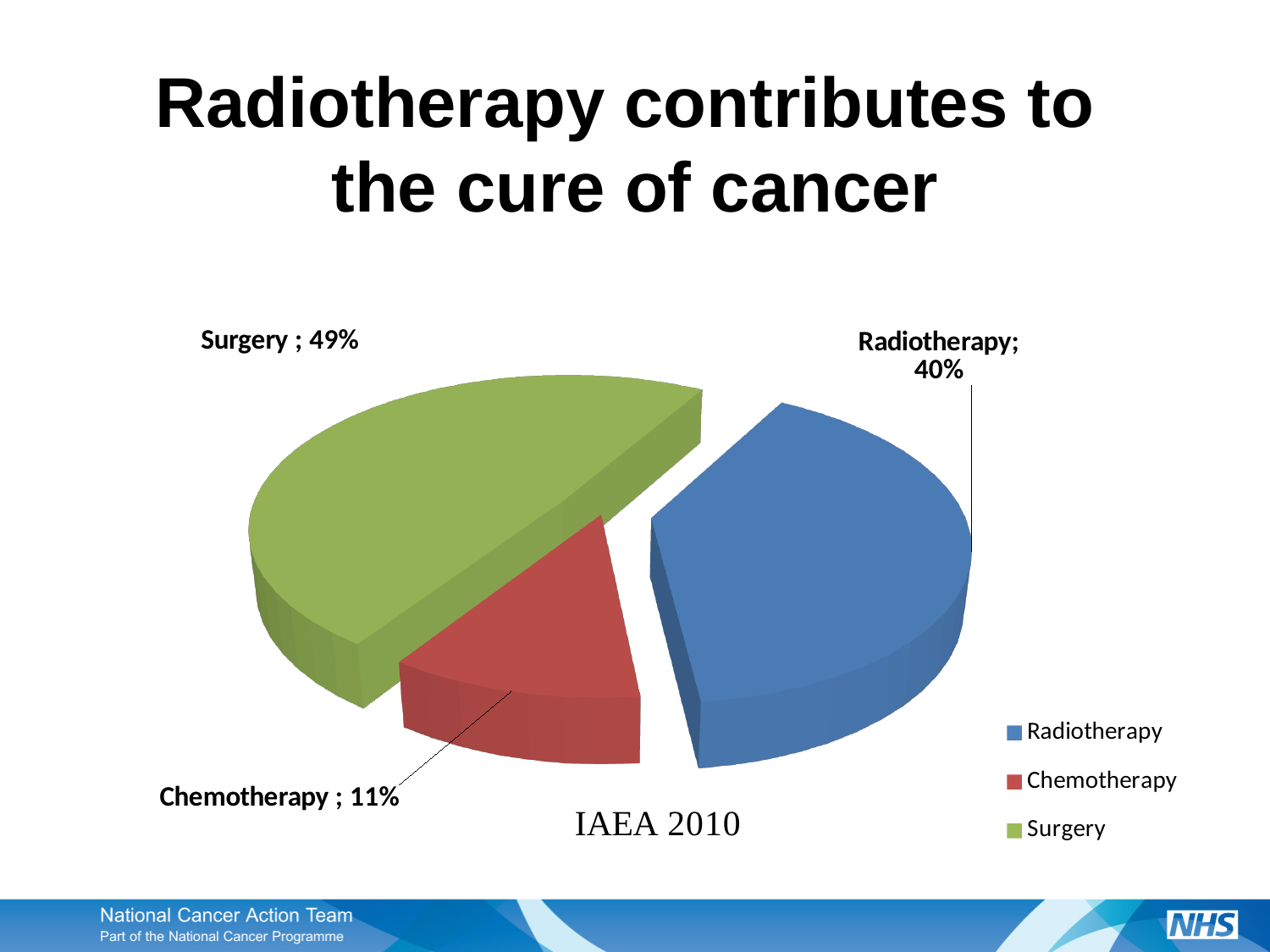
What share of the pie does Surgery account for? 49% What share of the pie does Chemotherapy account for? 11% What is the difference in percentage points between Radiotherapy and Chemotherapy? 29 What is the difference in percentage points between Surgery and Radiotherapy? 9 What type of chart is shown on the slide? Pie chart Which is larger, the Radiotherapy slice or the Chemotherapy slice? Radiotherapy What source is cited below the chart? IAEA 2010 What colour is the Surgery slice? Green How many categories are shown in the pie chart? 3 What share of the pie does Radiotherapy account for? 40% Which category has the smallest slice of the pie? Chemotherapy Which category has the largest slice of the pie? Surgery